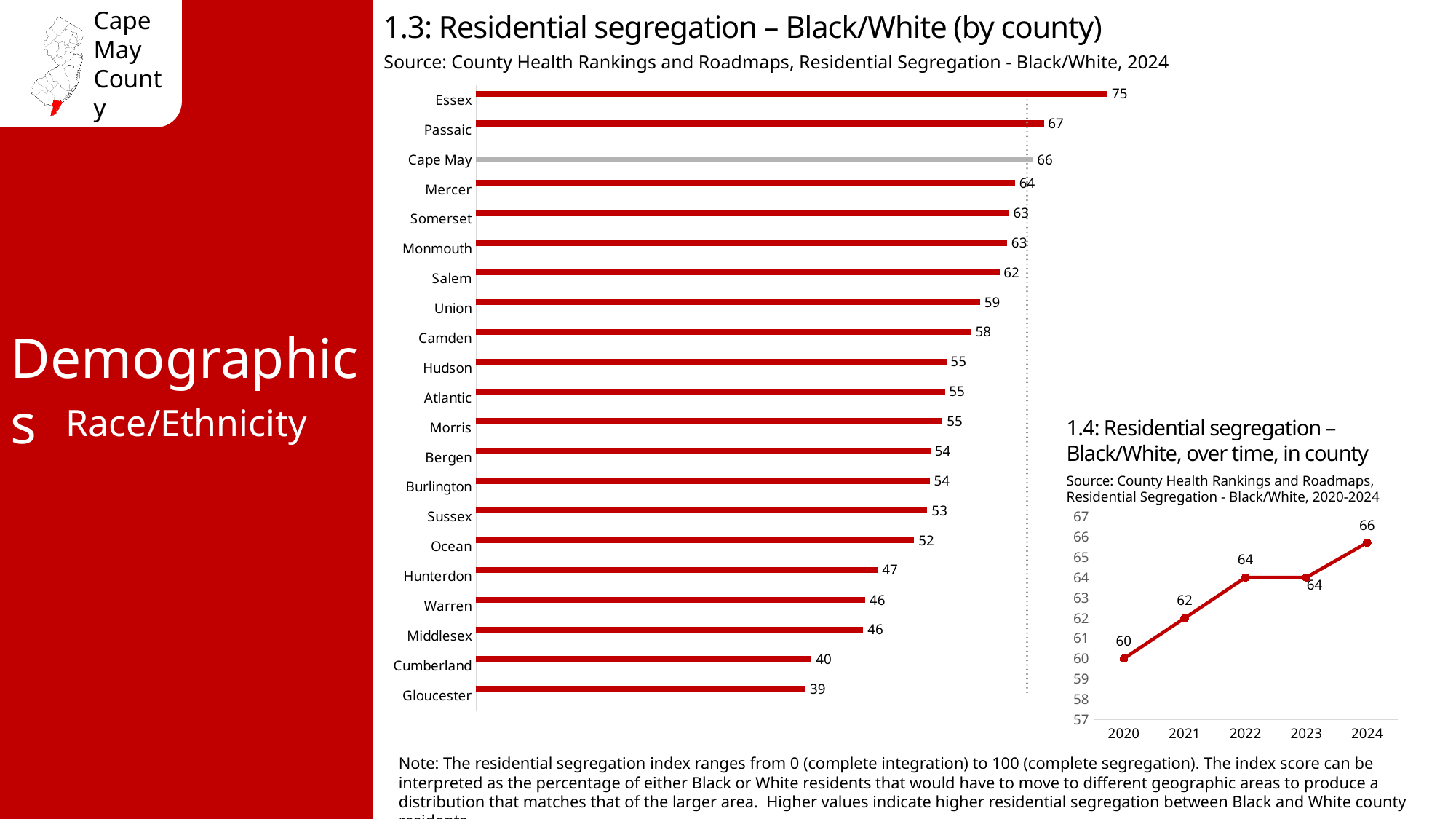
In chart 1.3 (by county), what is the value for Hunterdon? 47 In chart 1.3 (by county), which county has the highest value? Essex What kind of chart is chart 1.3 (by county)? Bar chart In chart 1.4 (over time, in county), do the values rise or fall from 2020 to 2024? Rise In chart 1.3 (Residential segregation – Black/White by county), what is the value for Cape May? 66 In chart 1.3 (by county), what is the difference between the values for Essex and Gloucester? 36 In chart 1.3 (by county), which county has the lowest value? Gloucester In chart 1.3 (by county), how many counties are shown? 21 In chart 1.3 (by county), which bar is shown in grey rather than red? Cape May In chart 1.3 (by county), which has a larger value, Passaic or Mercer? Passaic In chart 1.4 (over time, in county), what is the value for 2020? 60 In chart 1.4 (over time, in county), what is the difference between the 2024 and 2021 values? 4